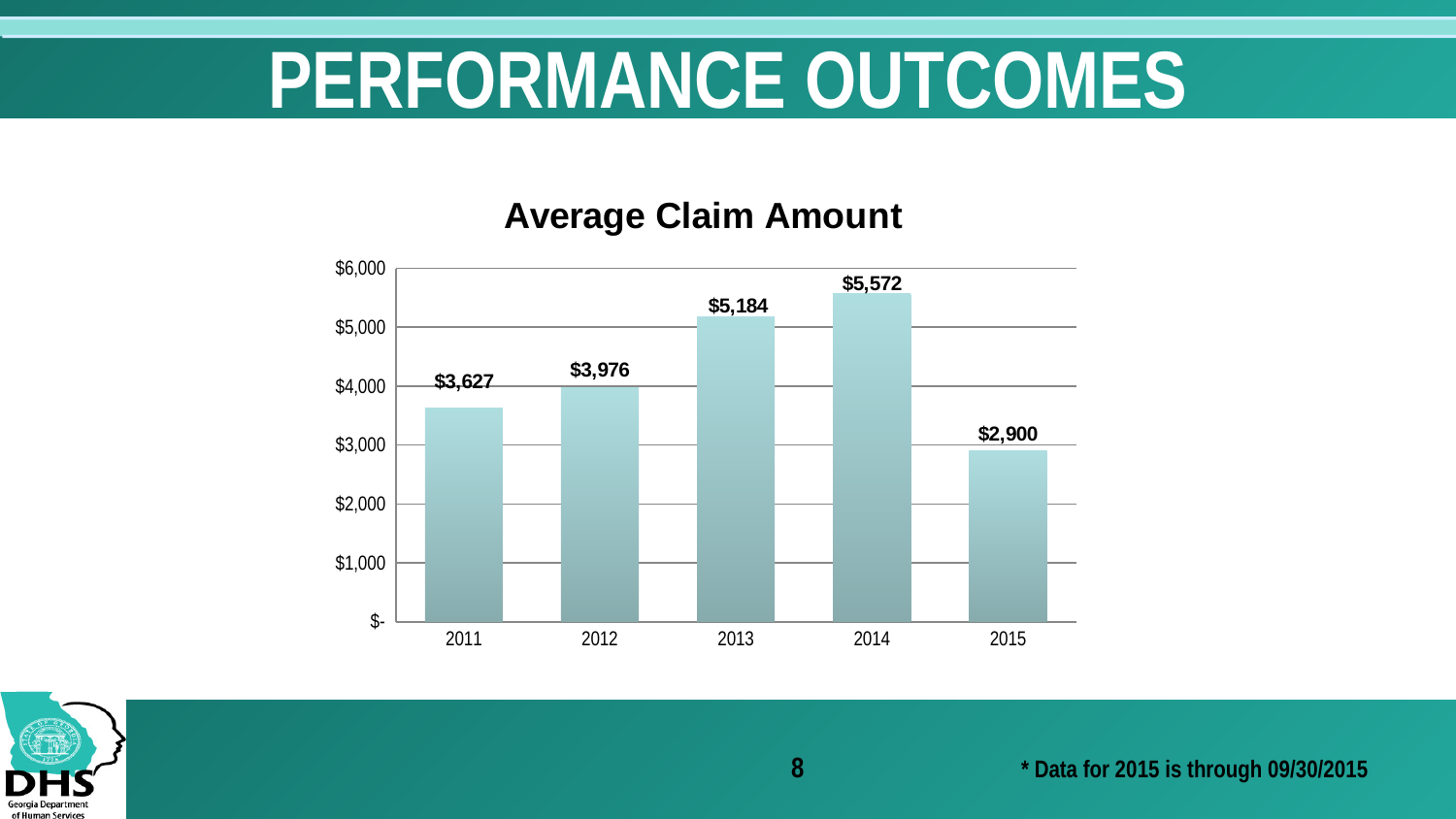
What is the average claim amount for 2013? $5,184 Is the average claim amount for 2014 greater or less than $5,000? greater Which year has the lowest average claim amount? 2015 What is the difference between the average claim amounts for 2012 and 2011? $349 Which year has the highest average claim amount? 2014 What is the average claim amount for 2011? $3,627 How many years are shown on the chart? 5 What is the title of the chart? Average Claim Amount Which year has a larger average claim amount, 2012 or 2015? 2012 What is the average claim amount for 2015? $2,900 What is the difference between the average claim amounts for 2014 and 2013? $388 What kind of chart is shown on the slide? Bar chart